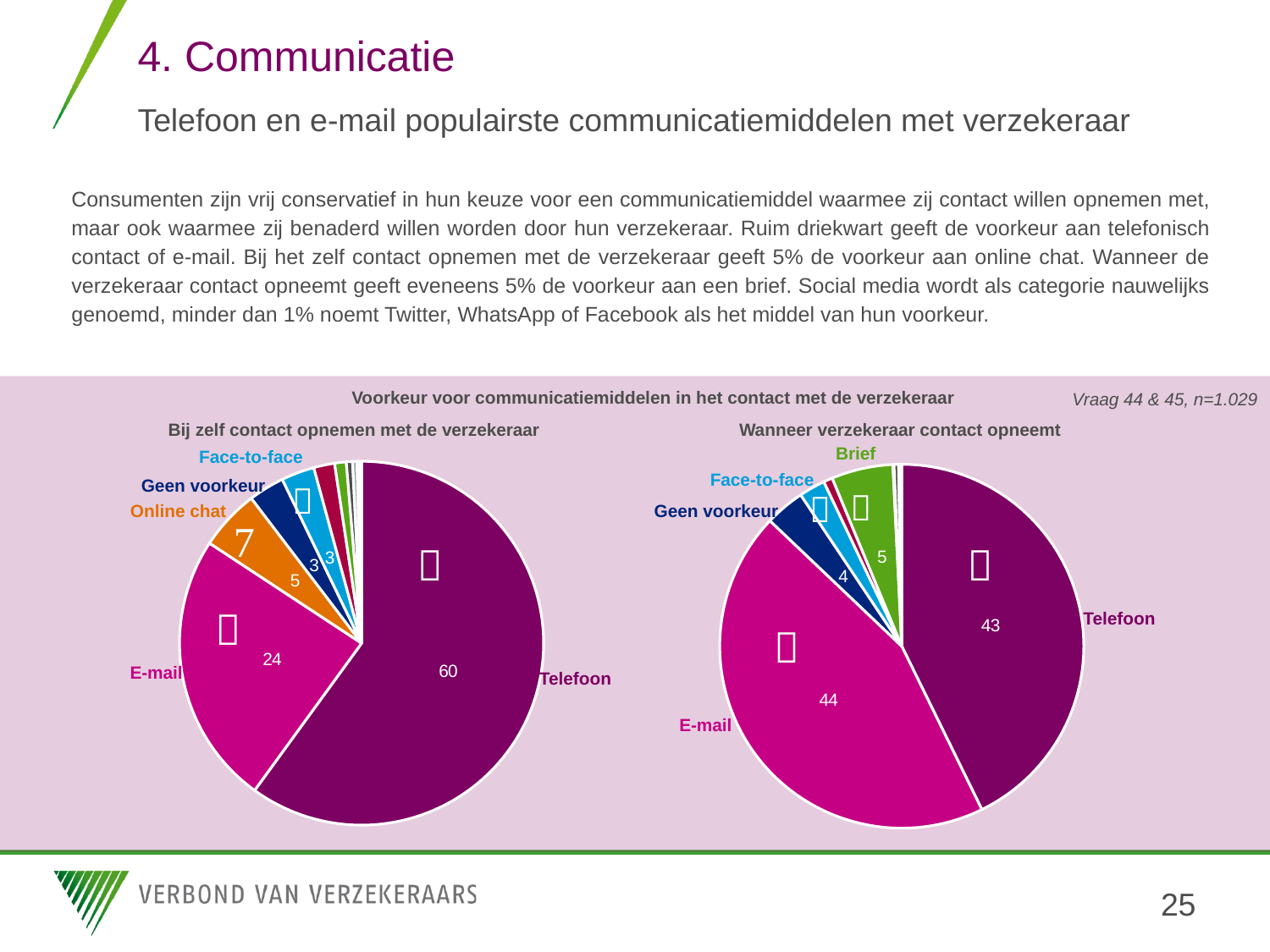
In the pie chart 'Bij zelf contact opnemen met de verzekeraar', what is the value for E-mail? 24 In the pie chart 'Bij zelf contact opnemen met de verzekeraar', what is the value for Online chat? 5 In the pie chart 'Bij zelf contact opnemen met de verzekeraar', which category has the largest slice? Telefoon In the pie chart 'Bij zelf contact opnemen met de verzekeraar', what is the difference between the values for Telefoon and E-mail? 36 What is the overall title above the two pie charts? Voorkeur voor communicatiemiddelen in het contact met de verzekeraar In the pie chart 'Wanneer verzekeraar contact opneemt', what is the value for Brief? 5 In the pie chart 'Bij zelf contact opnemen met de verzekeraar', which is larger: Online chat or Geen voorkeur? Online chat What type of chart is used on the left side of the slide? Pie chart In the pie chart 'Bij zelf contact opnemen met de verzekeraar', what is the value for Telefoon? 60 In the pie chart 'Wanneer verzekeraar contact opneemt', what is the value for Telefoon? 43 In the pie chart 'Wanneer verzekeraar contact opneemt', which category has the largest slice? E-mail In the pie chart 'Wanneer verzekeraar contact opneemt', what is the value for E-mail? 44